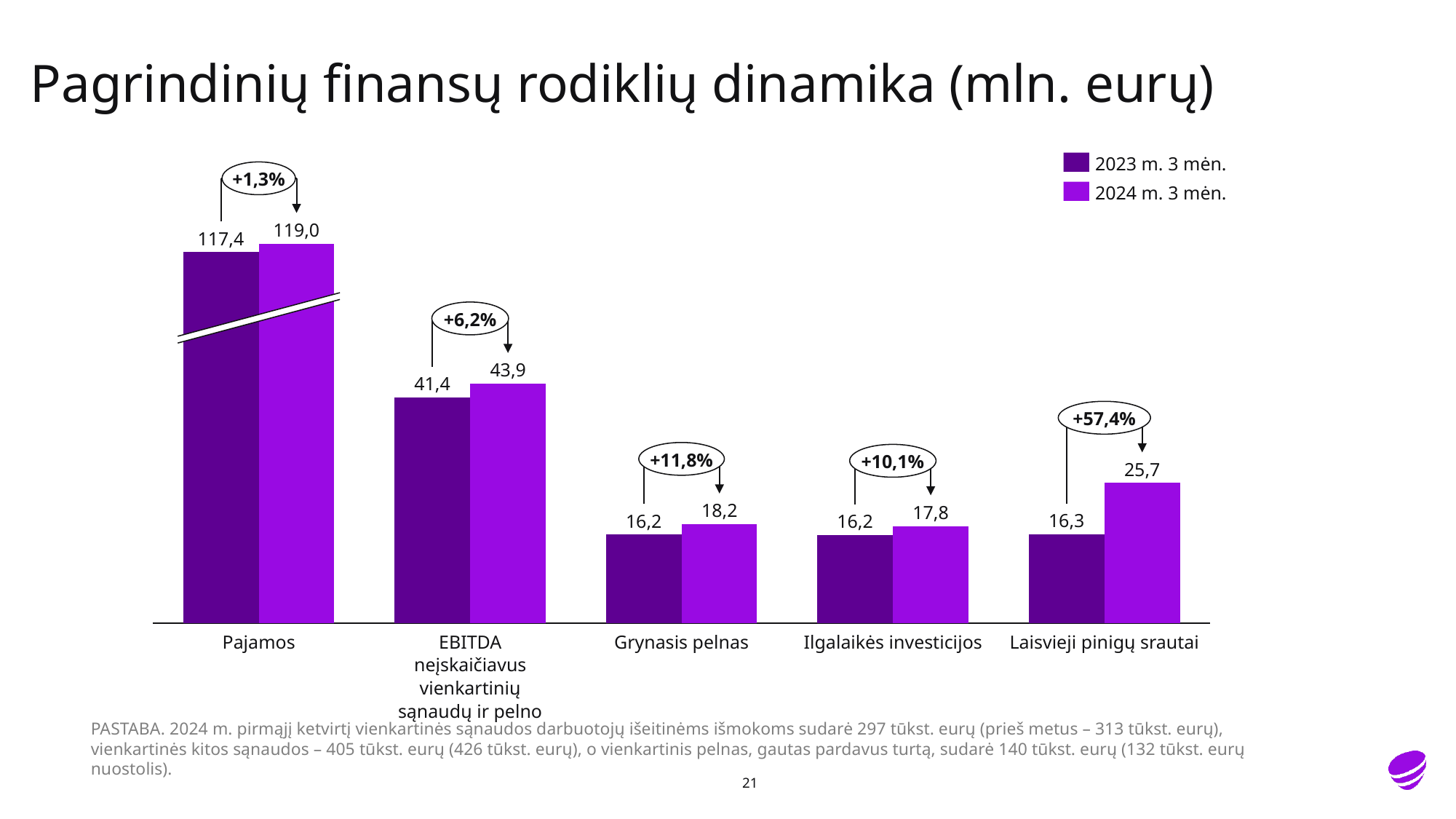
What is the value for Pajamos in the 2024 m. 3 mėn. series? 119,0 What is the 2024 m. 3 mėn. value for Grynasis pelnas? 18,2 What is the difference between the 2024 m. 3 mėn. and 2023 m. 3 mėn. values for Laisvieji pinigų srautai? 9,4 Which is larger: the 2024 m. 3 mėn. value for Grynasis pelnas or for Ilgalaikės investicijos? Grynasis pelnas What percentage change is shown above the Laisvieji pinigų srautai bars? +57,4% Which category has the lowest value in the 2024 m. 3 mėn. series? Ilgalaikės investicijos Which category has the highest value in the 2024 m. 3 mėn. series? Pajamos How many series does the legend list? 2 What is the difference between the 2024 m. 3 mėn. and 2023 m. 3 mėn. values for Pajamos? 1,6 How many categories are shown on the x axis? 5 What kind of chart is shown on the slide? Bar chart What is the value for Laisvieji pinigų srautai in the 2023 m. 3 mėn. series? 16,3